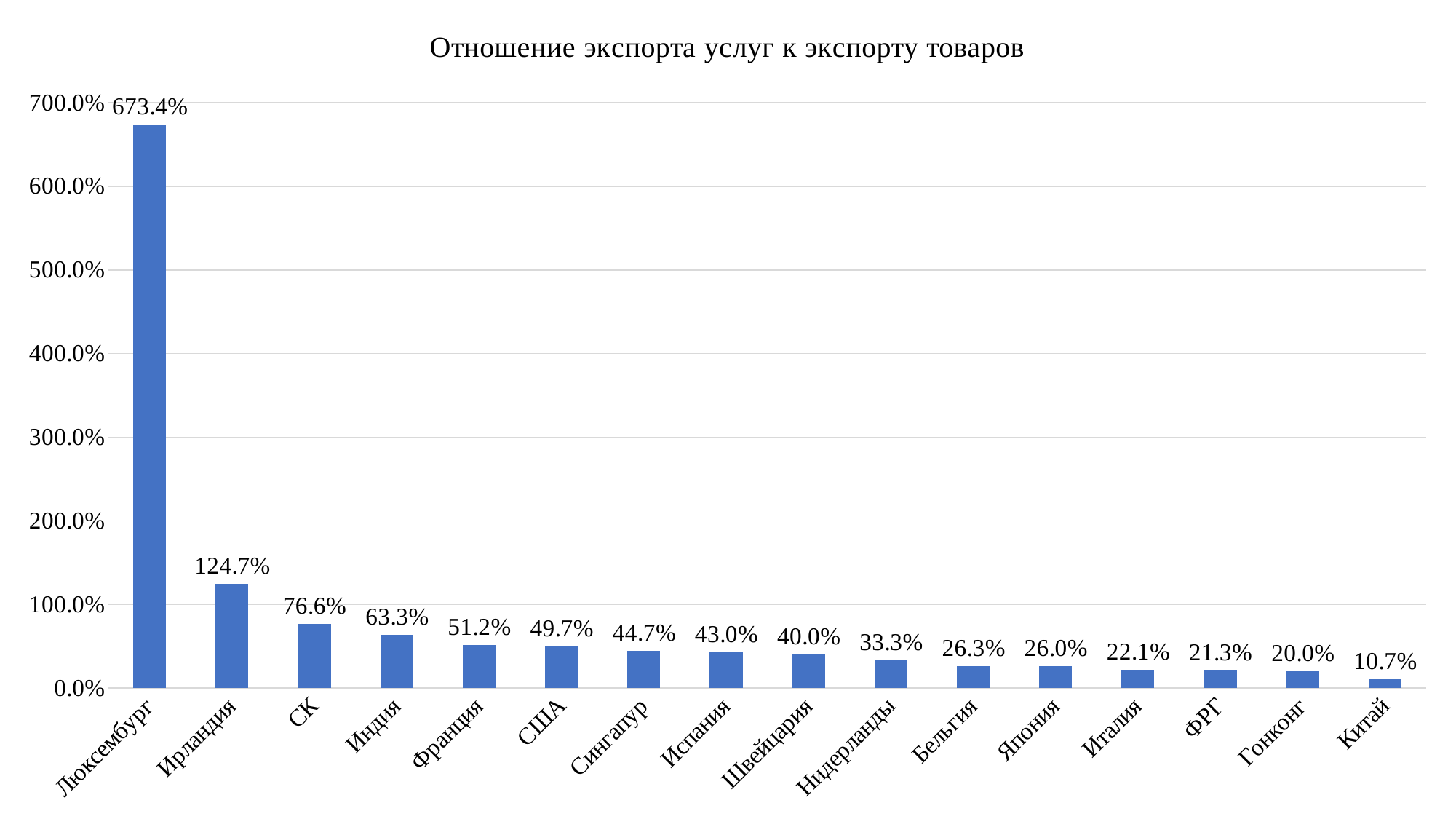
Is the value for Ирландия greater or less than 100.0%? greater Which country has the lowest value? Китай What is the value for Швейцария? 40.0% Which is larger, the value for Франция or the value for США? Франция What is the title of the chart? Отношение экспорта услуг к экспорту товаров What kind of chart is this? bar chart How many countries are shown on the chart? 16 What is the difference between the values for СК and Индия? 13.3% Which country has the highest value? Люксембург Do the values rise or fall from left to right along the x axis? fall What is the value for Люксембург? 673.4% What is the value for Ирландия? 124.7%